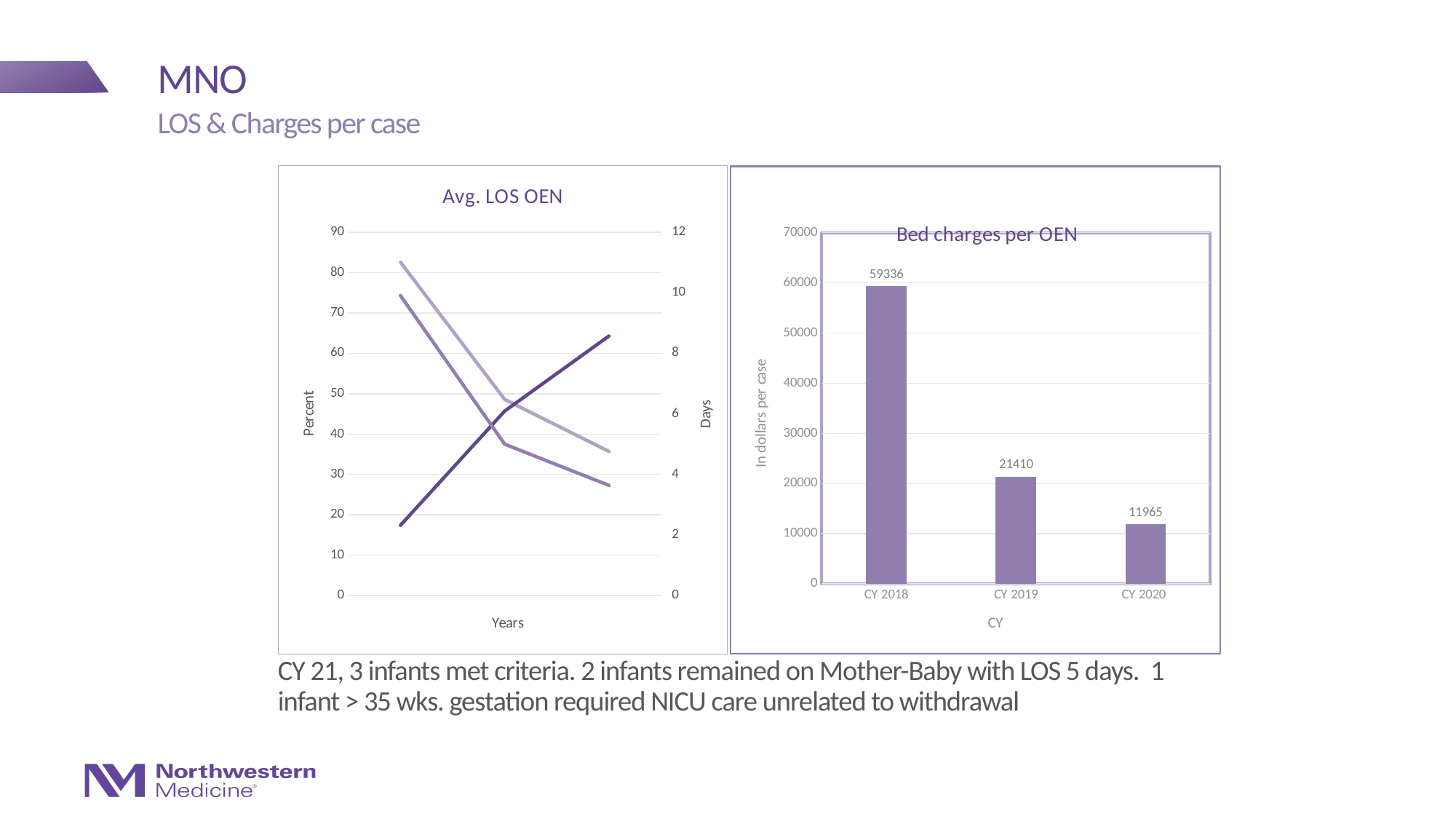
In the Bed charges per OEN chart, what is the value for CY 2018? 59336 In the Bed charges per OEN chart, which year has the highest bed charges? CY 2018 In the Bed charges per OEN chart, which year has the lowest bed charges? CY 2020 In the Bed charges per OEN chart, is the value for CY 2018 greater or less than 50000? greater Do the values in the Bed charges per OEN chart rise or fall from CY 2018 to CY 2020? fall In the Bed charges per OEN chart, what is the value for CY 2020? 11965 How many categories are shown in the Bed charges per OEN chart? 3 What kind of chart is the Avg. LOS OEN chart on the left? line chart In the Bed charges per OEN chart, which is larger, the value for CY 2019 or CY 2020? CY 2019 In the Bed charges per OEN chart, what is the value for CY 2019? 21410 In the Bed charges per OEN chart, what is the difference between the values for CY 2018 and CY 2019? 37926 In the Bed charges per OEN chart, what is the difference between the values for CY 2019 and CY 2020? 9445